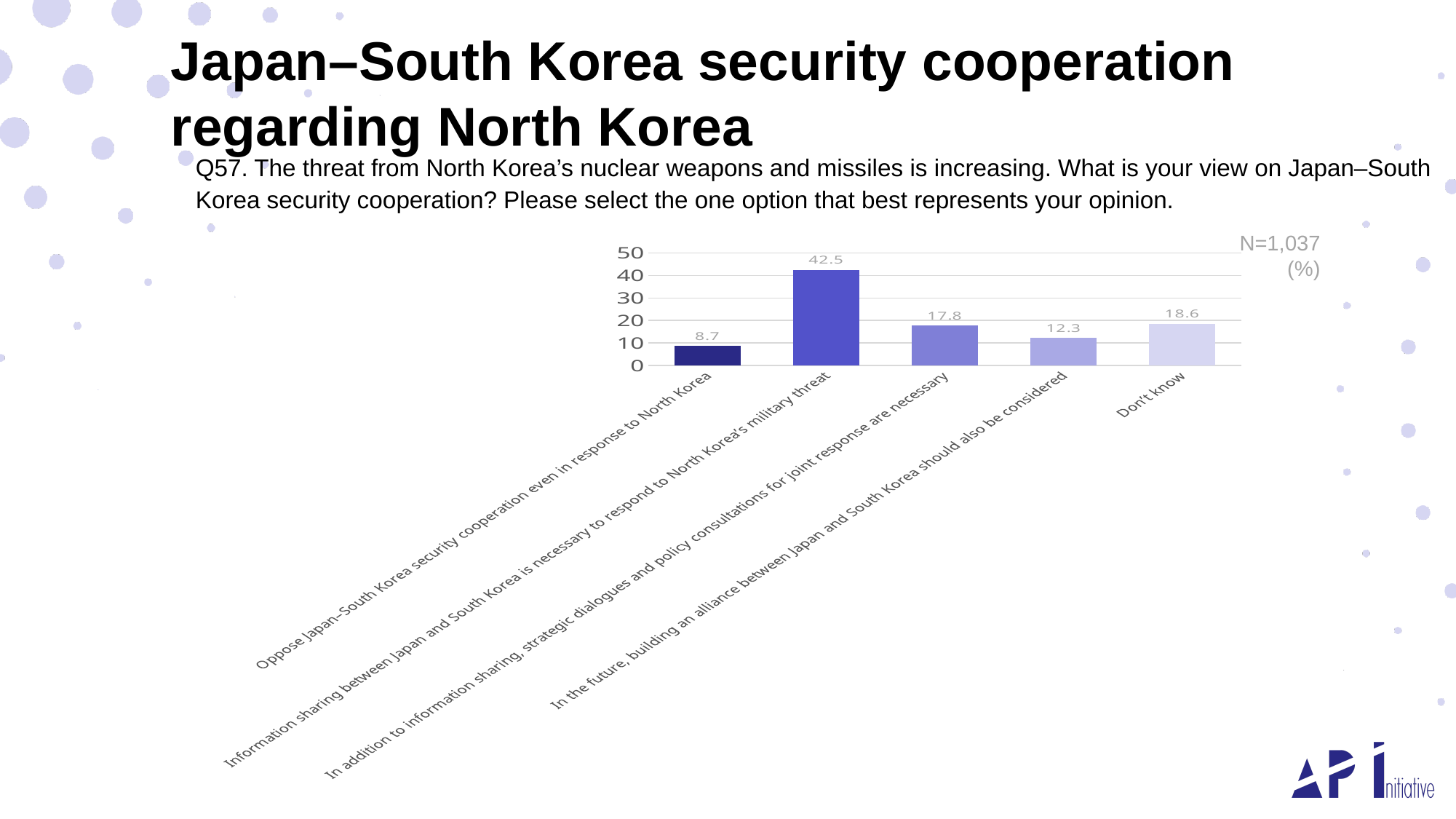
What is the value for "Don't know"? 18.6 Is the value for "Information sharing between Japan and South Korea is necessary to respond to North Korea's military threat" greater or less than 40? greater What is the value for "Information sharing between Japan and South Korea is necessary to respond to North Korea's military threat"? 42.5 What kind of chart is shown on the slide? bar chart What is the sample size (N) shown next to the chart? N=1,037 How many categories are shown in the chart? 5 Which is larger: the value for "Don't know" or the value for "In addition to information sharing, strategic dialogues and policy consultations for joint response are necessary"? Don't know Which category has the highest value? Information sharing between Japan and South Korea is necessary to respond to North Korea's military threat What is the difference between the value for "Don't know" and the value for "In the future, building an alliance between Japan and South Korea should also be considered"? 6.3 What is the value for "In the future, building an alliance between Japan and South Korea should also be considered"? 12.3 Which category has the lowest value? Oppose Japan–South Korea security cooperation even in response to North Korea What is the value for "Oppose Japan–South Korea security cooperation even in response to North Korea"? 8.7